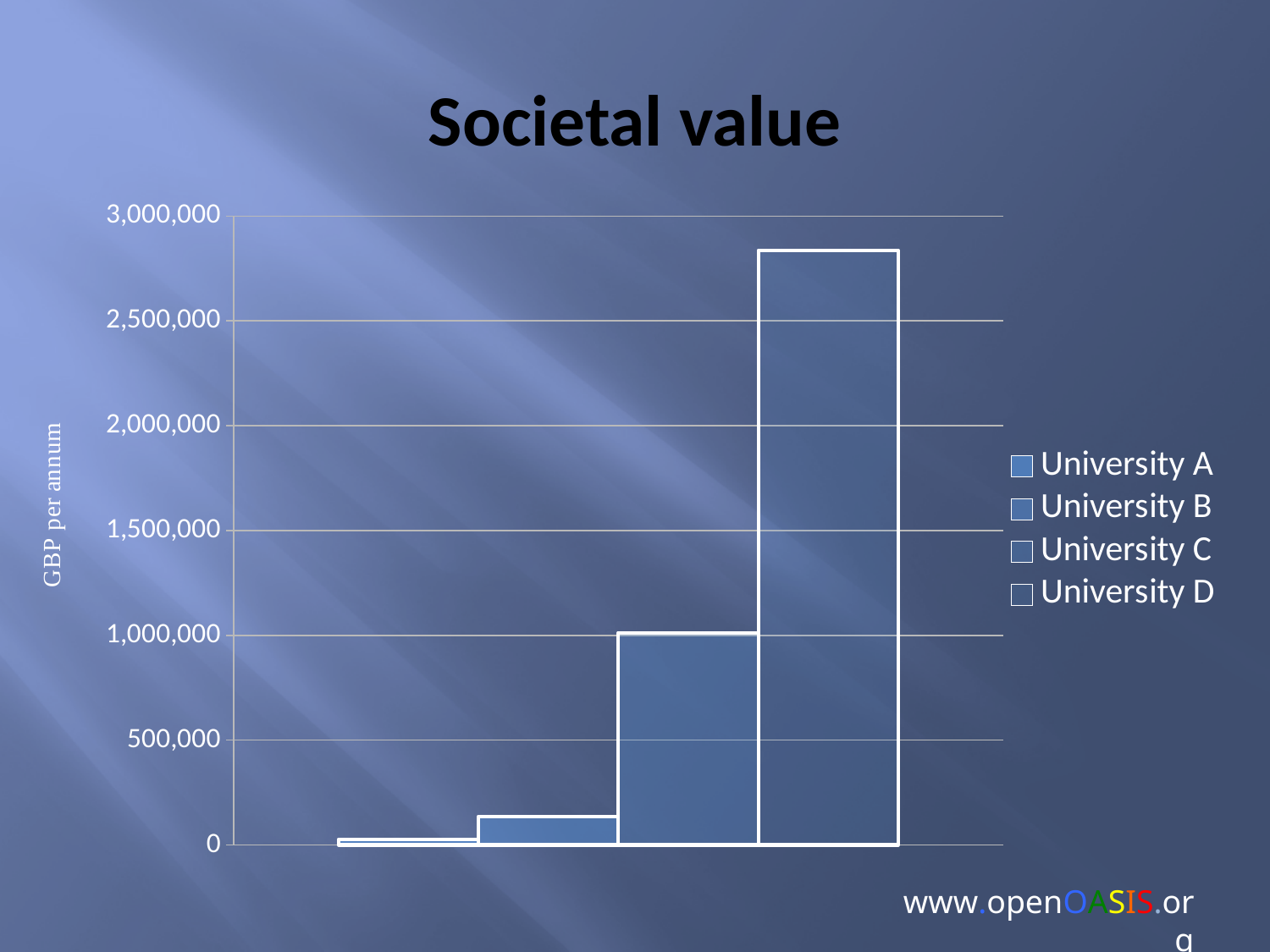
What is the label on the vertical axis of the chart? GBP per annum Is the value for University D greater or less than 3,000,000? less Is the value for University D greater or less than 2,500,000? greater Which is larger, the value for University C or University D? University D Do the values rise or fall going from University A to University D? rise What kind of chart is shown on the slide? bar chart Which university has the highest societal value? University D How many series does the legend list? 4 Which is larger, the value for University B or University C? University C Is the value for University B greater or less than 500,000? less Which university has the lowest societal value? University A